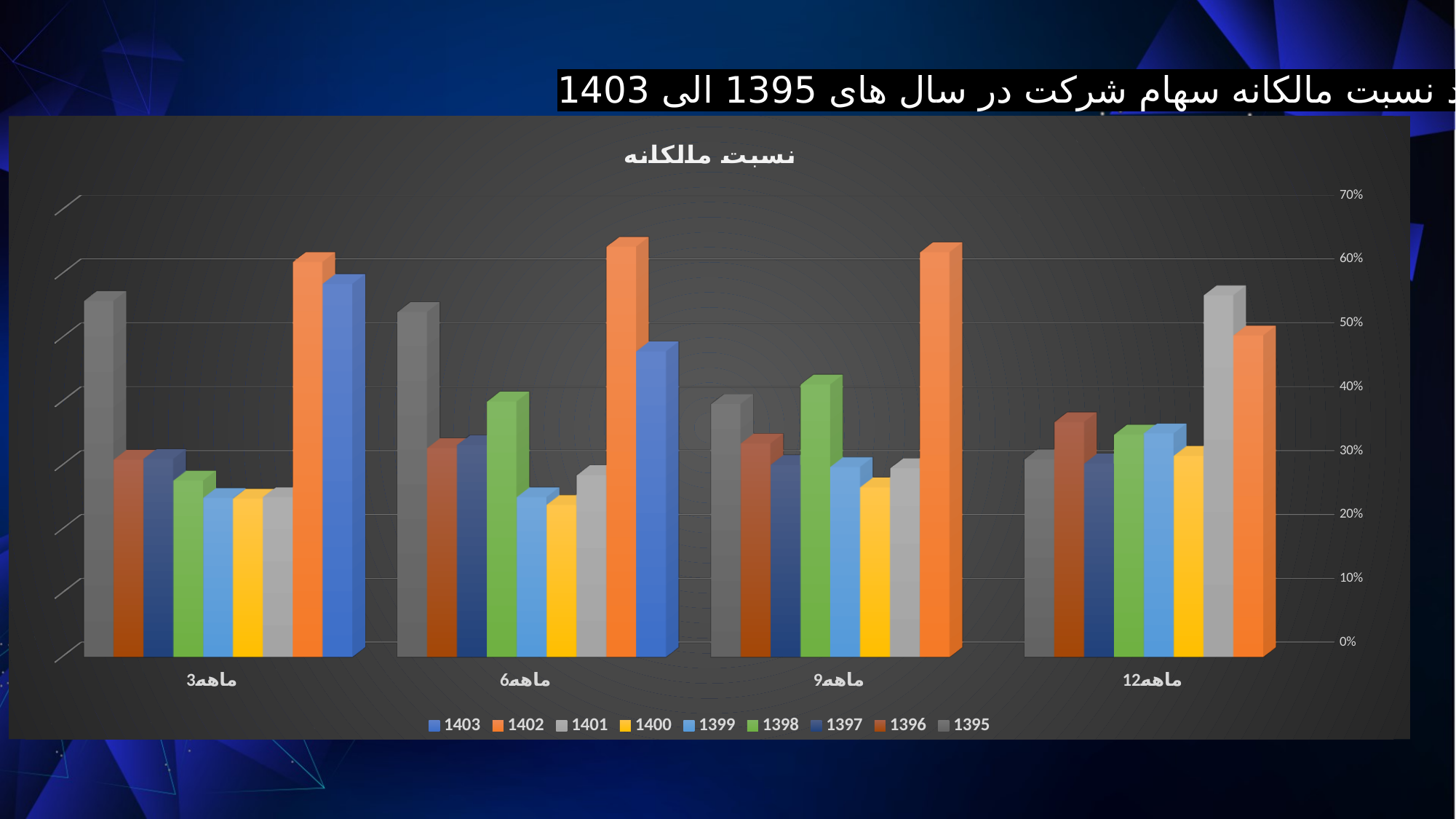
Which series has the highest value in the 6 ماهه category? 1402 Is the value for 1402 in the 9 ماهه category greater or less than 50%? greater How many series does the legend list? 9 Is the value for 1400 in the 6 ماهه category greater or less than 30%? less How many categories are shown on the x axis? 4 Which series has the highest value in the 12 ماهه category? 1401 Which series has the highest value in the 9 ماهه category? 1402 Is the value for 1398 in the 6 ماهه category greater or less than 30%? greater What is the title of the chart? نسبت مالکانه What kind of chart is shown on the slide? bar chart In the 9 ماهه category, which is larger: the value for 1398 or the value for 1400? 1398 For the 1395 series, which category has the larger value: 3 ماهه or 12 ماهه? 3 ماهه